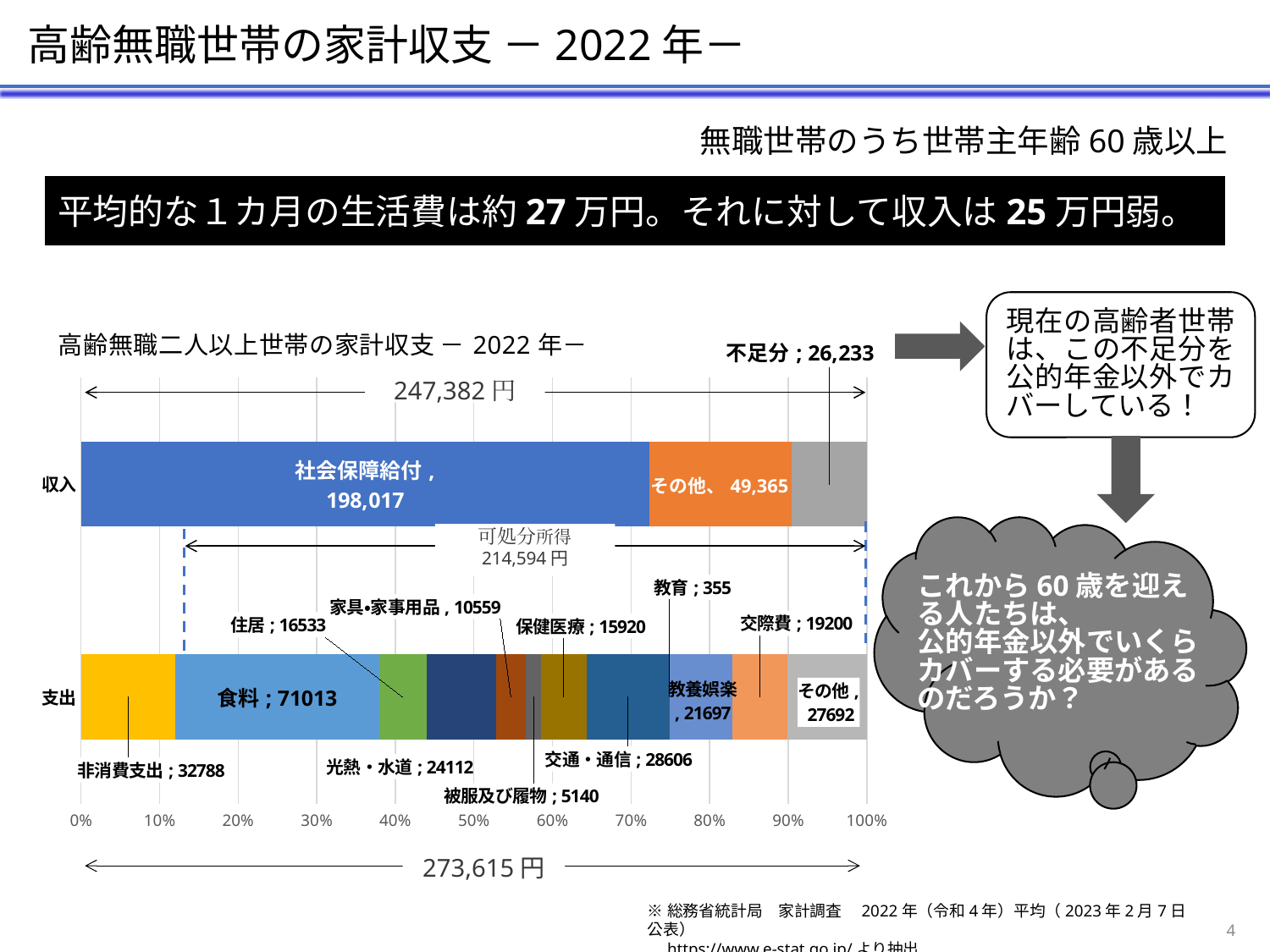
Which category in the 支出 bar has the smallest value? 教育 What is the difference between 食料 (71013) and 非消費支出 (32788) in the 支出 bar? 38225 What is the value of 社会保障給付 in the 収入 bar? 198,017 Which is larger in the 支出 bar, 交通・通信 or 光熱・水道? 交通・通信 What is the value of 可処分所得 shown on the chart? 214,594 円 What is the total of the 支出 bar as printed below the chart? 273,615 円 What is the value of 食料 in the 支出 bar? 71013 What kind of chart is shown on the slide? Stacked bar chart Which category in the 支出 bar has the largest value? 食料 What is the value labelled 不足分 on the chart? 26,233 What is the difference between 社会保障給付 (198,017) and その他 (49,365) in the 収入 bar? 148,652 How many segments make up the 支出 bar? 12